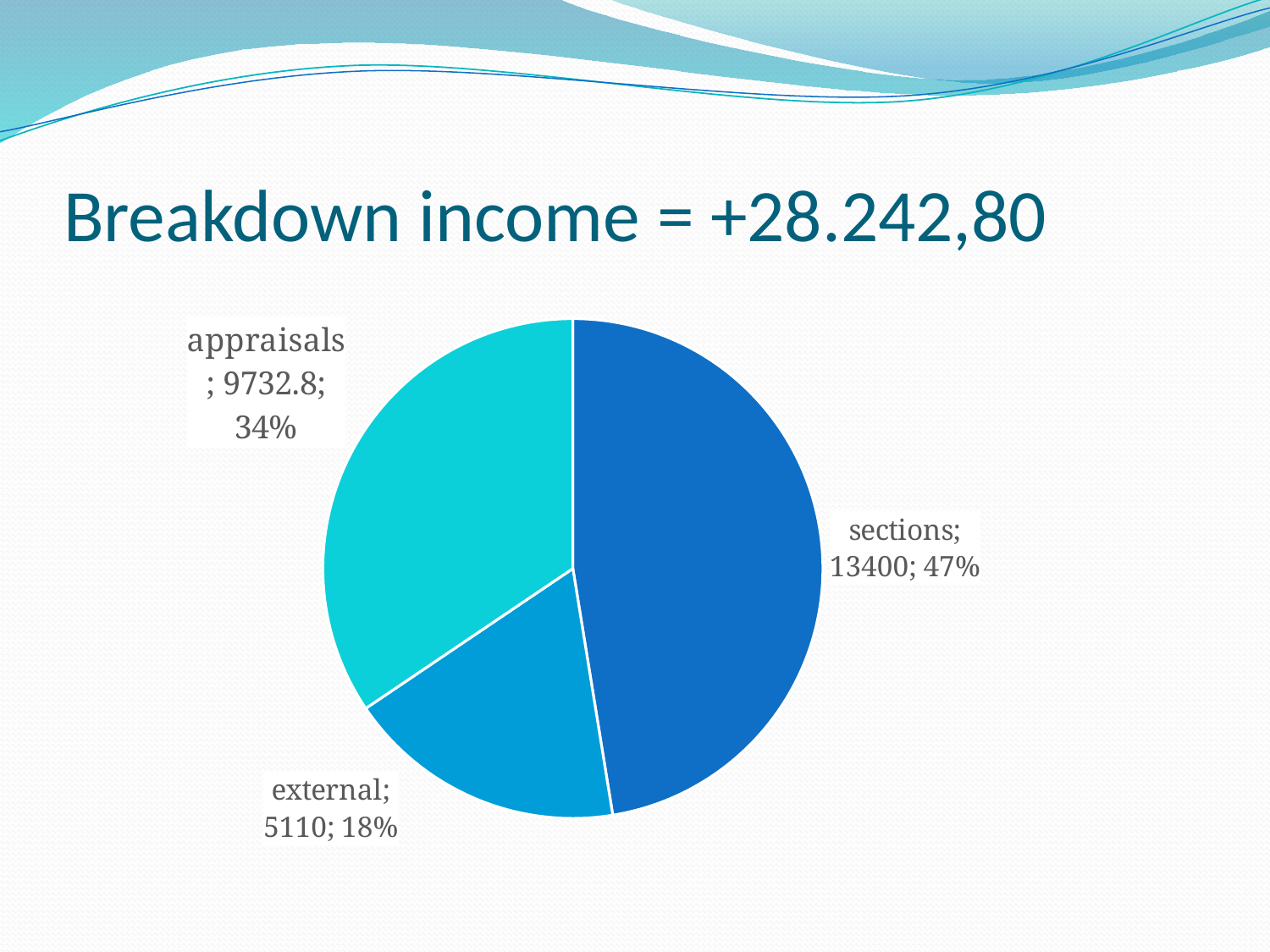
What share of the pie does appraisals represent? 34% What share of the pie does sections represent? 47% Which is larger, the value for appraisals or the value for external? appraisals Which category has the largest slice? sections What is the value for sections? 13400 What is the difference between the values for sections and external? 8290 Which category has the smallest slice? external How many slices does the pie chart have? 3 What type of chart is shown on the slide? pie chart What is the value for appraisals? 9732.8 What is the value for external? 5110 What share of the pie does external represent? 18%